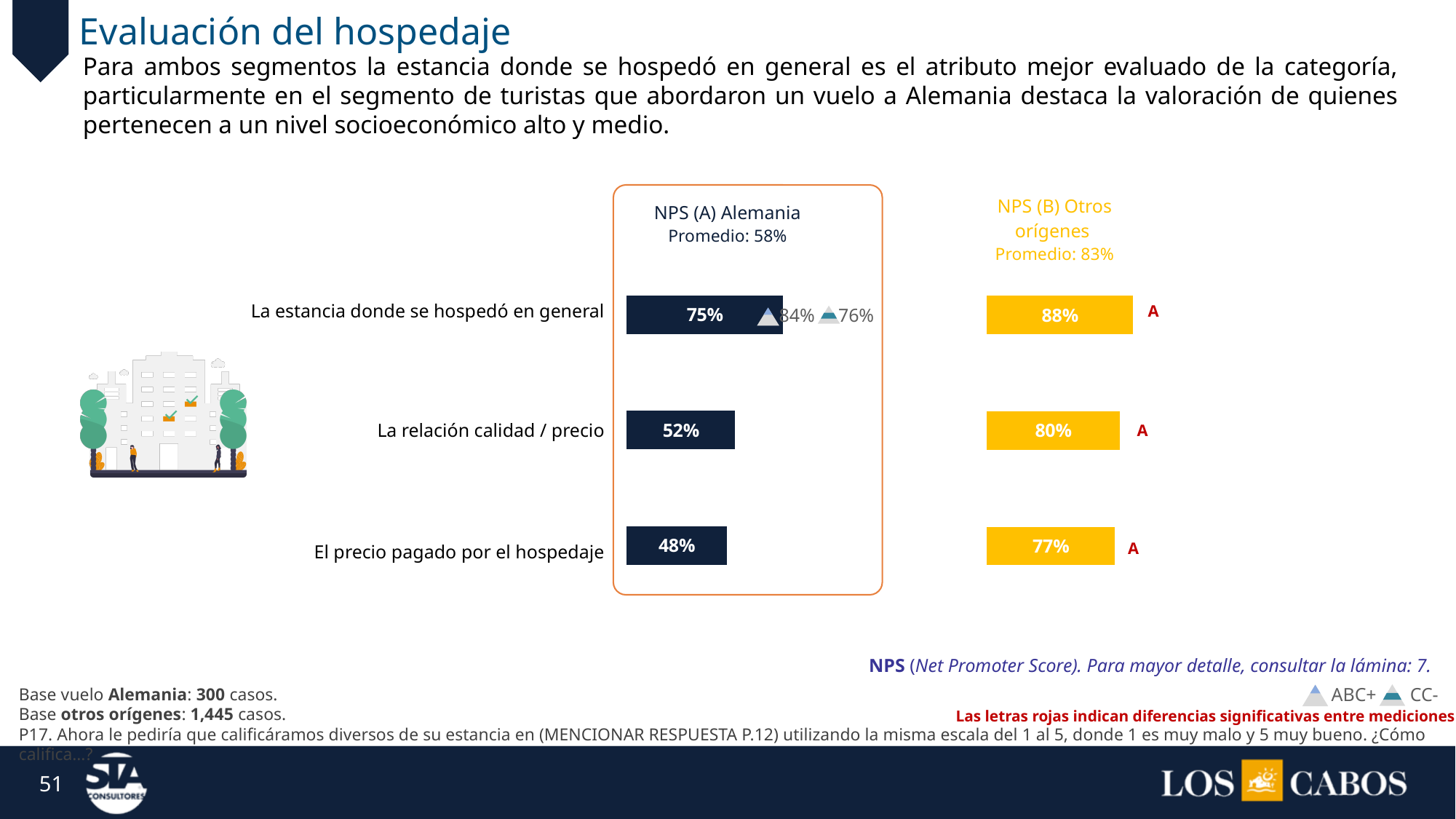
How many categories are shown in the NPS (A) Alemania chart? 3 What is the difference between the NPS (B) Otros orígenes value and the NPS (A) Alemania value for 'La estancia donde se hospedó en general'? 13% In the NPS (A) Alemania chart, what is the ABC+ value shown next to 'La estancia donde se hospedó en general'? 84% In the NPS (A) Alemania chart, what is the value for 'El precio pagado por el hospedaje'? 48% In the NPS (B) Otros orígenes chart, what is the value for 'La relación calidad / precio'? 80% In the NPS (B) Otros orígenes chart, which category has the highest value? La estancia donde se hospedó en general In the NPS (A) Alemania chart, what is the value for 'La estancia donde se hospedó en general'? 75% What is the 'Promedio' shown for NPS (B) Otros orígenes? 83% In the NPS (A) Alemania chart, what is the difference between 'La relación calidad / precio' and 'El precio pagado por el hospedaje'? 4% What kind of chart is used to show the NPS (B) Otros orígenes values? Bar chart In the NPS (A) Alemania chart, which category has the lowest value? El precio pagado por el hospedaje For 'El precio pagado por el hospedaje', which is larger: the NPS (A) Alemania value or the NPS (B) Otros orígenes value? NPS (B) Otros orígenes